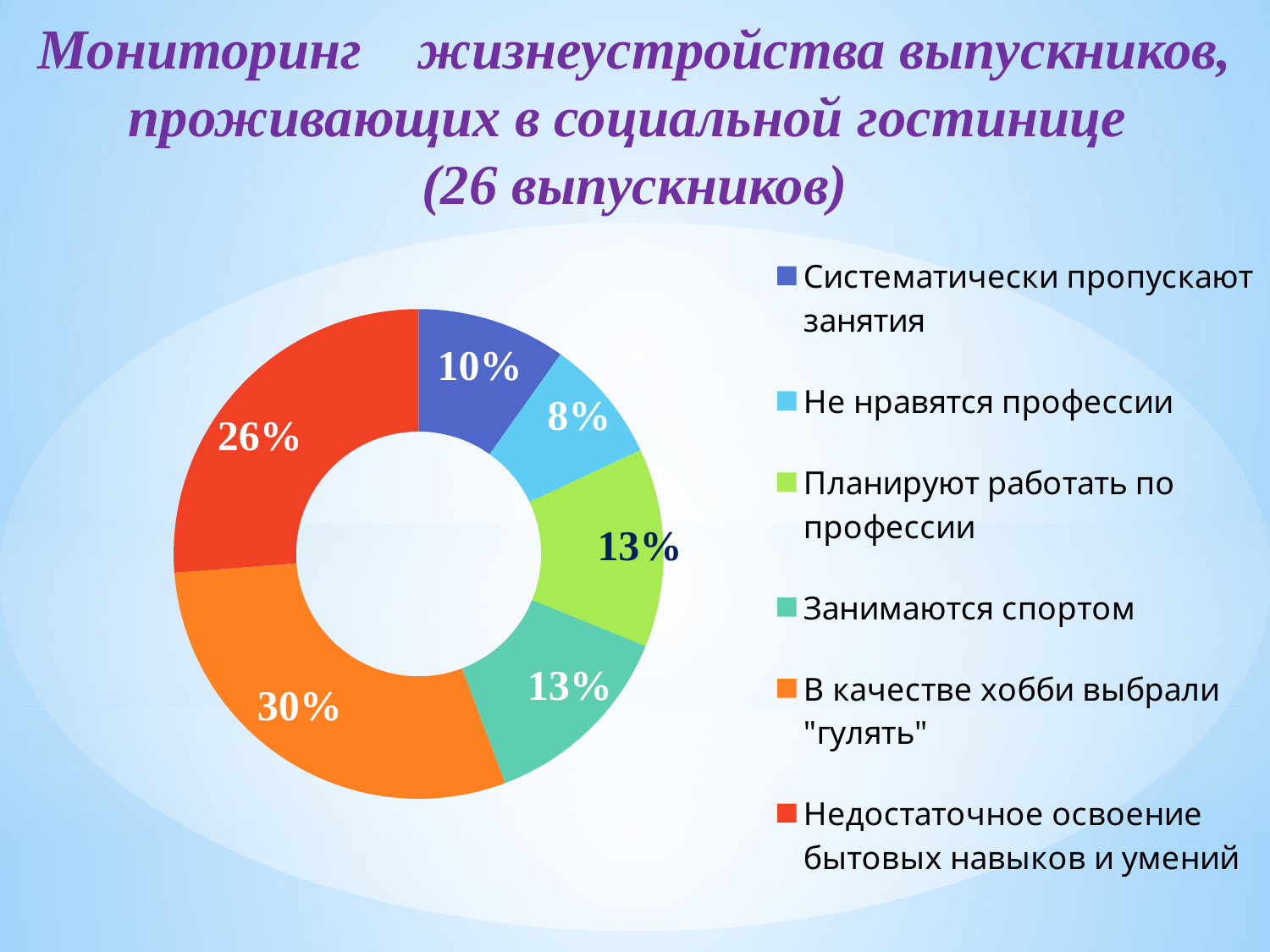
What share of the chart does "В качестве хобби выбрали "гулять"" represent? 30% What percentage is shown for "Не нравятся профессии"? 8% Which category has the largest share of the chart? В качестве хобби выбрали "гулять" What is the difference between the shares for "В качестве хобби выбрали "гулять"" and "Недостаточное освоение бытовых навыков и умений"? 4% Which category has the smallest share of the chart? Не нравятся профессии What kind of chart is shown on the slide? Doughnut chart What is the value for "Систематически пропускают занятия"? 10% How many categories does the chart show? 6 Which two categories have the same share of 13%? Планируют работать по профессии and Занимаются спортом What colour is the segment for "Недостаточное освоение бытовых навыков и умений"? Red Which is larger: the share for "Систематически пропускают занятия" or for "Не нравятся профессии"? Систематически пропускают занятия What is the value shown for "Недостаточное освоение бытовых навыков и умений"? 26%